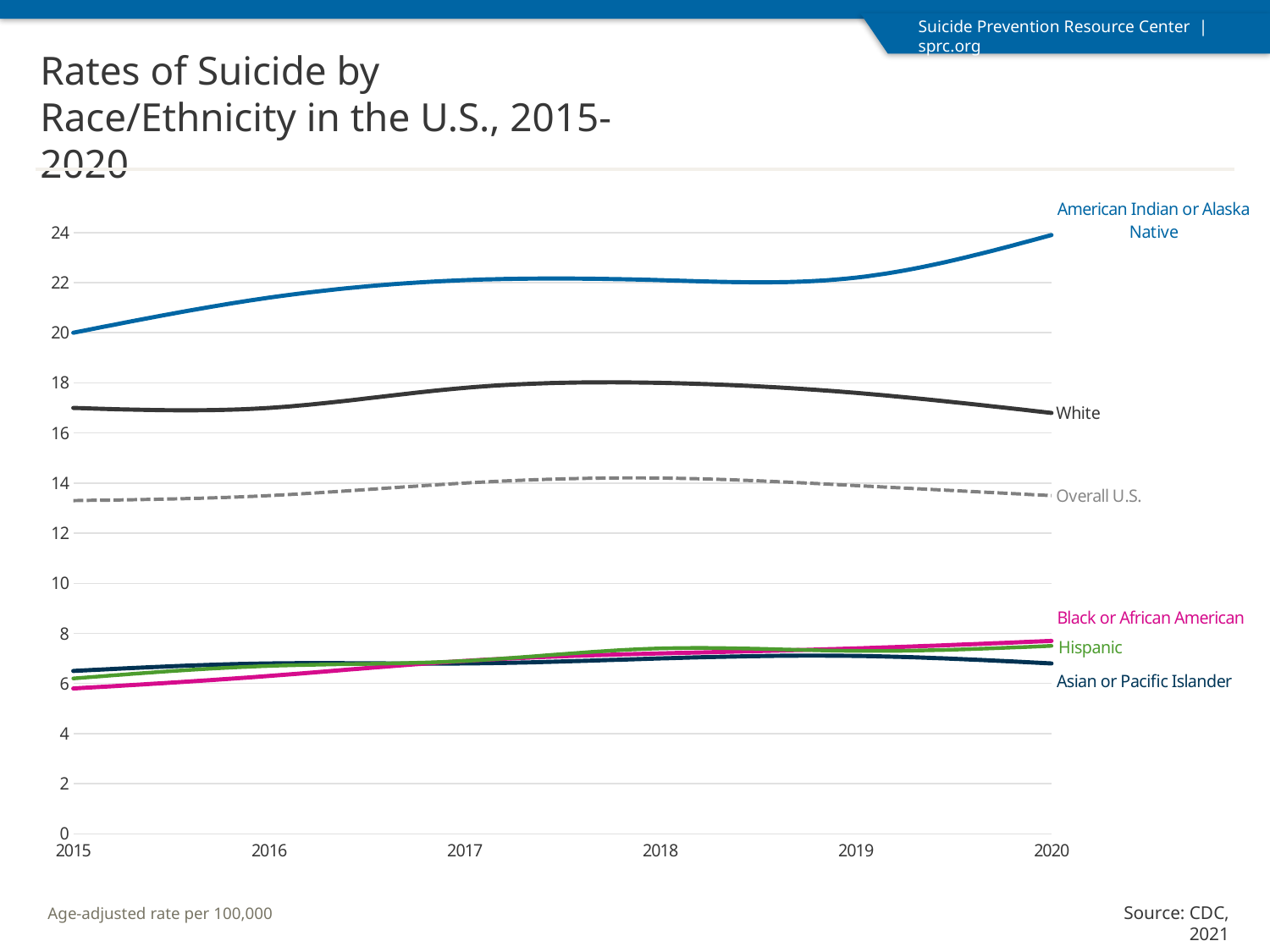
Is the 2015 value for American Indian or Alaska Native greater or less than 22? less What is the source cited for the chart data? CDC, 2021 In 2018, which is larger: the rate for White or the rate for Overall U.S.? White Which group has the lowest suicide rate in 2020? Asian or Pacific Islander How many series (race/ethnicity groups, including Overall U.S.) are plotted on the chart? 6 Is the 2020 value for American Indian or Alaska Native greater or less than 22? greater How many years are shown along the x axis of the chart? 6 Is the 2015 value for Overall U.S. greater or less than 14? less What kind of chart is shown on the slide? Line chart Does the American Indian or Alaska Native line rise or fall from 2015 to 2020? rise Which group has the highest suicide rate in 2020? American Indian or Alaska Native